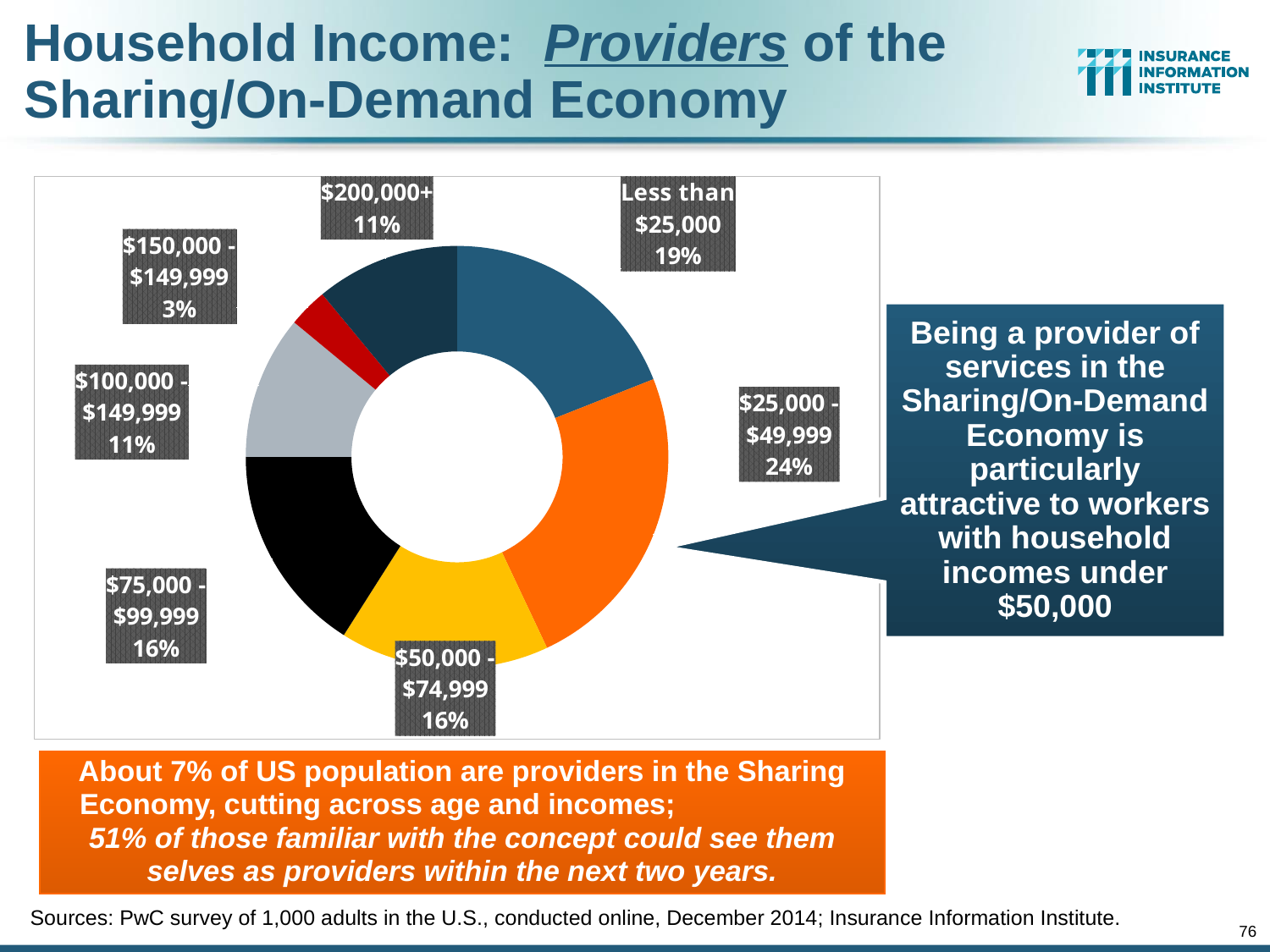
What is the difference in percentage points between the $25,000 - $49,999 slice and the Less than $25,000 slice? 5 percentage points What share of providers have household incomes of $75,000 - $99,999? 16% What share of providers have household incomes of $200,000+? 11% What share of providers have household incomes of $25,000 - $49,999? 24% How many household income categories are shown in the chart? 7 Which household income category has the largest share of providers? $25,000 - $49,999 What share of providers have household incomes of less than $25,000? 19% Which household income category has the smallest share of providers? $150,000 - $149,999 Which is larger: the share for $100,000 - $149,999 or the share for $75,000 - $99,999? $75,000 - $99,999 What is the combined share of providers with household incomes under $50,000? 43% What colour is the slice for $25,000 - $49,999? Orange What kind of chart is shown on the slide? Pie chart (donut)